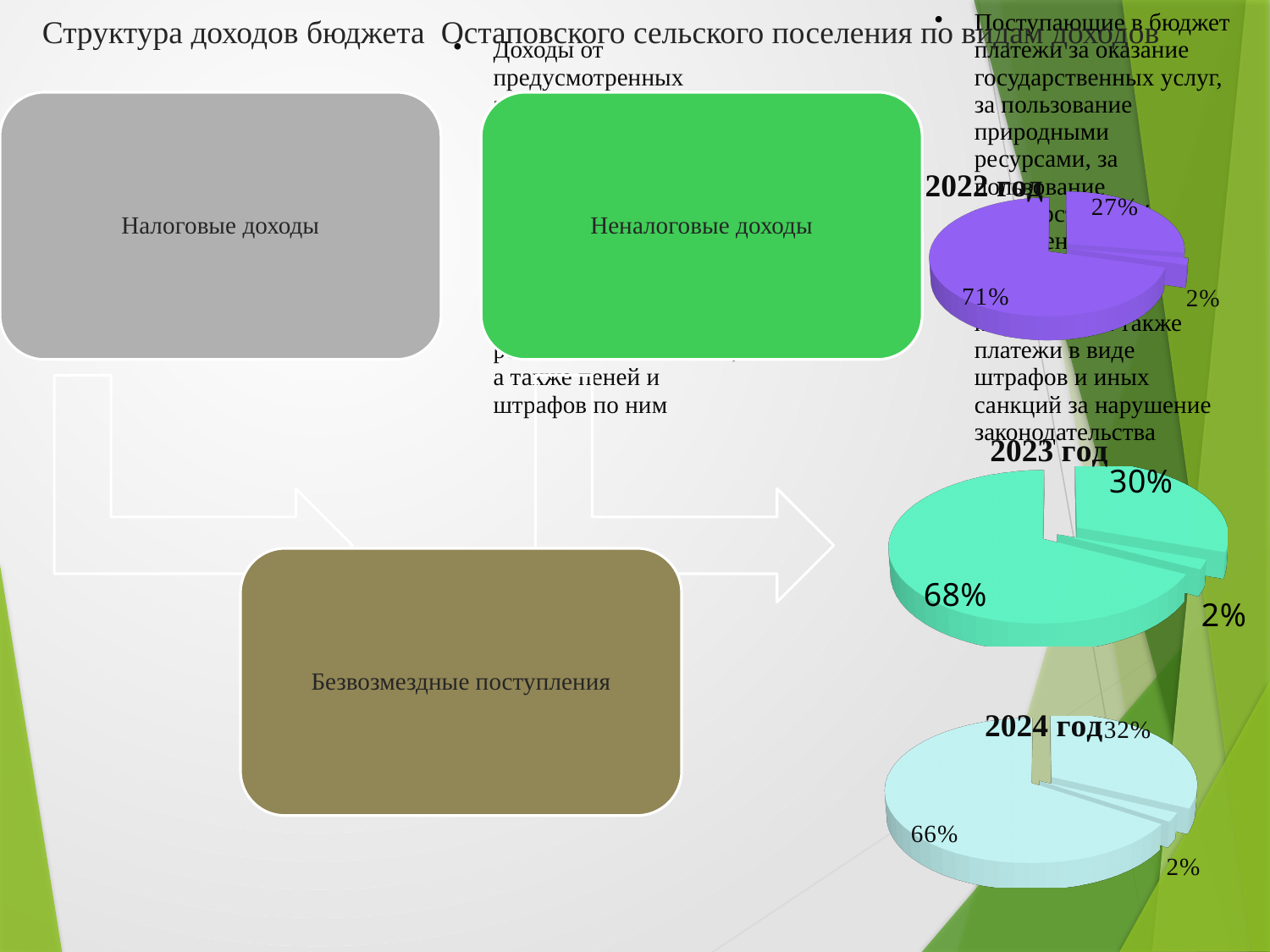
In the 2023 год pie chart, what is the share of the smallest slice? 2% In the 2022 год pie chart, what is the difference between the largest slice and the second-largest slice? 44% How many slices does the 2022 год pie chart have? 3 In the 2024 год pie chart, what is the share of the largest slice? 66% In the 2023 год pie chart, what is the share of the largest slice? 68% In the 2023 год pie chart, what is the difference between the largest slice and the second-largest slice? 38% In the 2024 год pie chart, what is the share of the second-largest slice? 32% What kind of chart is used for the 2022 год chart? pie chart How many pie charts are shown on the slide? 3 In the 2022 год pie chart, what is the share of the largest slice? 71% In the 2022 год pie chart, what is the share of the smallest slice? 2% Which pie chart has the larger largest slice, 2022 год or 2024 год? 2022 год